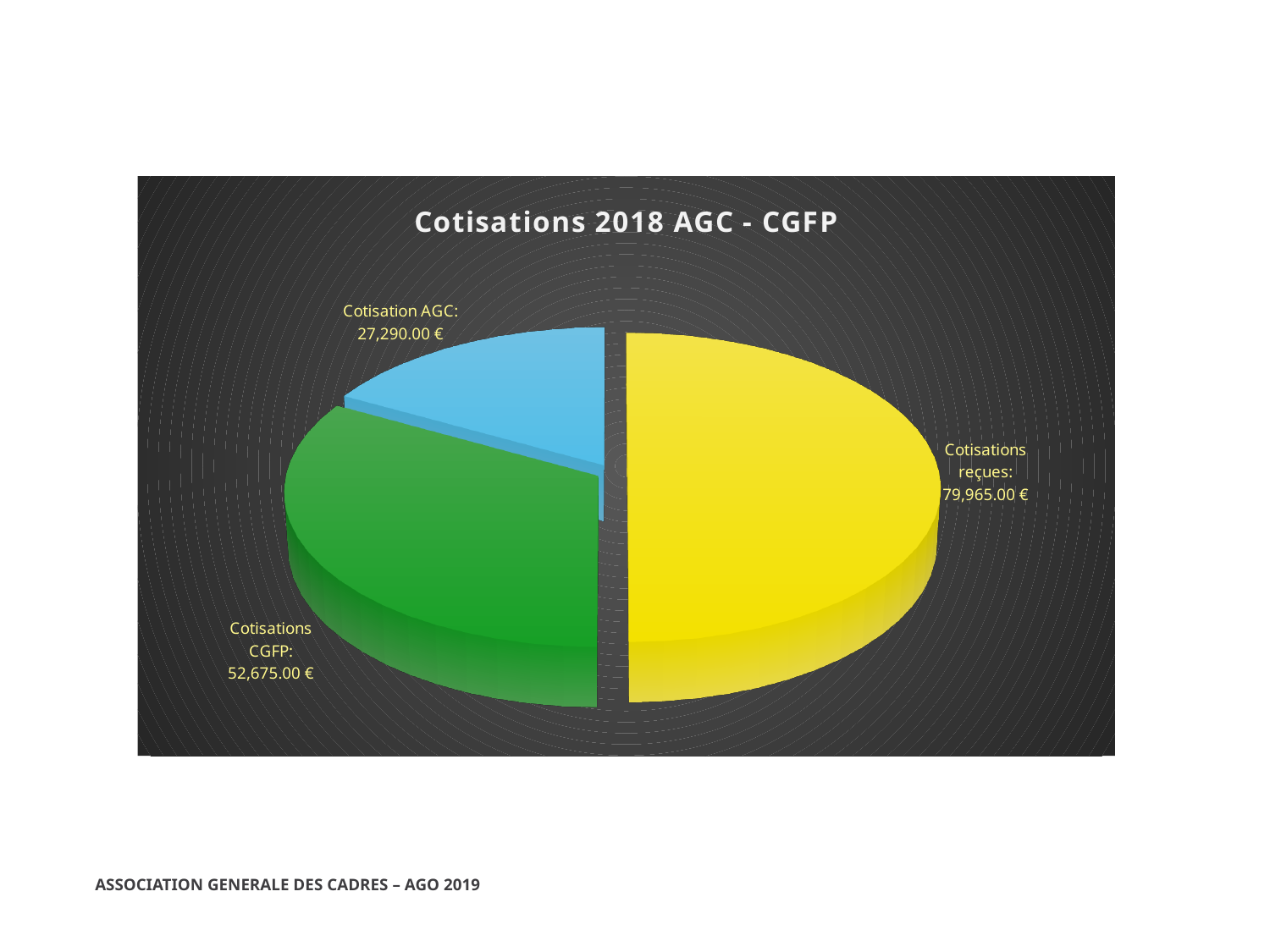
What is the title of the chart? Cotisations 2018 AGC - CGFP Which slice of the pie is the smallest? Cotisation AGC What is the value of the Cotisations reçues slice? 79,965.00 € What share of the pie does the Cotisations reçues slice represent? 50% What is the value of the Cotisation AGC slice? 27,290.00 € Which is larger, Cotisations CGFP or Cotisation AGC? Cotisations CGFP What kind of chart is shown on the slide? Pie chart Which slice of the pie is the largest? Cotisations reçues What is the value of the Cotisations CGFP slice? 52,675.00 € What is the difference between Cotisations reçues and Cotisations CGFP? 27,290.00 € How many slices does the pie chart have? 3 What is the difference between Cotisations CGFP and Cotisation AGC? 25,385.00 €